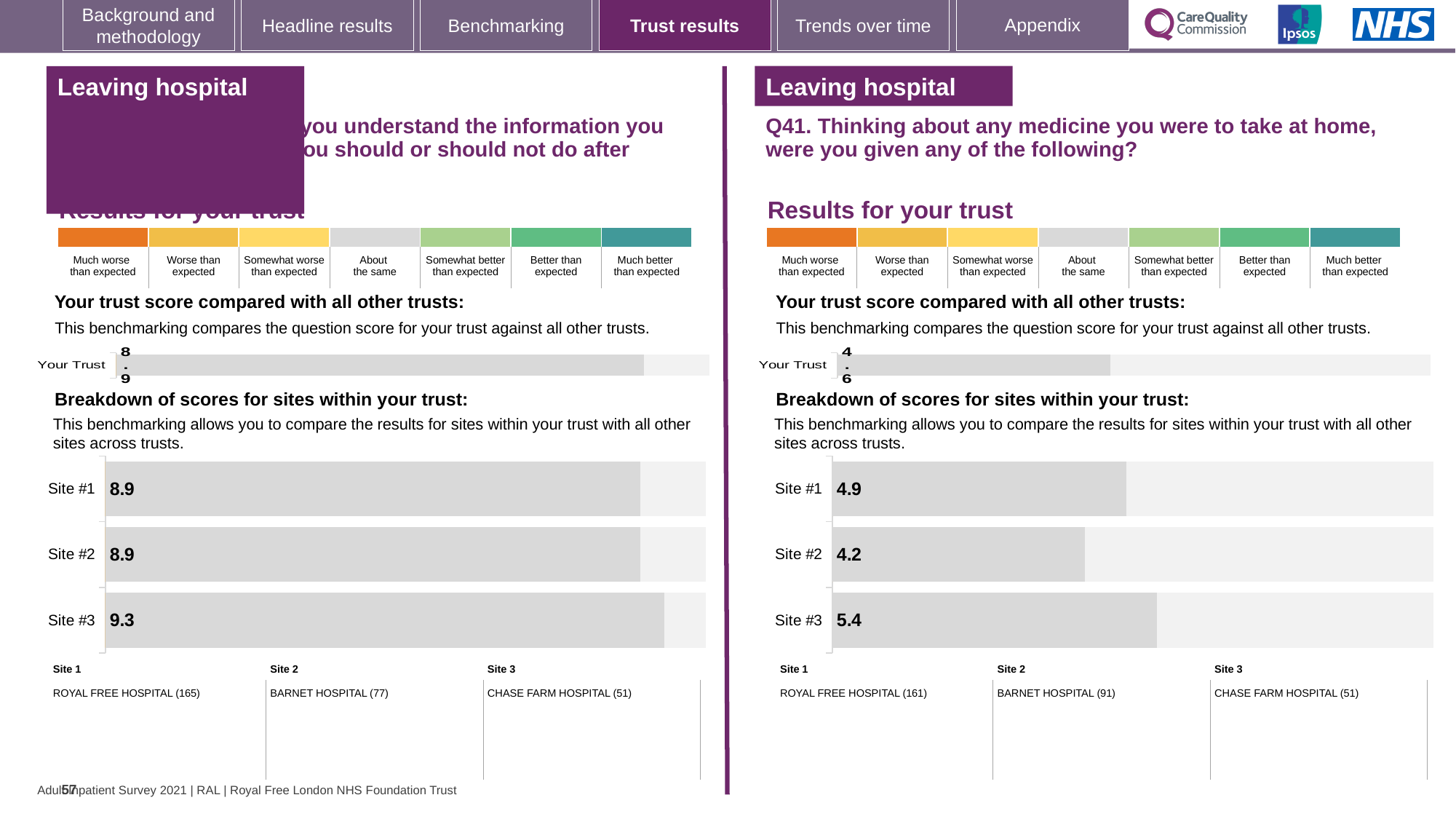
In the left-hand site breakdown chart, which site has the highest score? Site #3 In the left-hand site breakdown chart, what is the difference between the scores for Site #3 and Site #1? 0.4 In the right-hand (Q41) site breakdown chart, what is the difference between the scores for Site #3 and Site #2? 1.2 What type of chart is used for the site breakdown on the left-hand side of the slide? Bar chart In the right-hand (Q41) site breakdown chart, which site has the lowest score? Site #2 In the left-hand 'Your Trust' chart, what is the trust score shown? 8.9 In the right-hand (Q41) site breakdown chart, what is the score for Site #2? 4.2 In the left-hand site breakdown chart, what is the score for Site #3? 9.3 In the right-hand (Q41) site breakdown chart, which site has the highest score? Site #3 In the right-hand (Q41) 'Your Trust' chart, what is the trust score shown? 4.6 In the right-hand (Q41) site breakdown chart, what is the score for Site #3? 5.4 How many sites are shown in the right-hand (Q41) site breakdown chart? 3